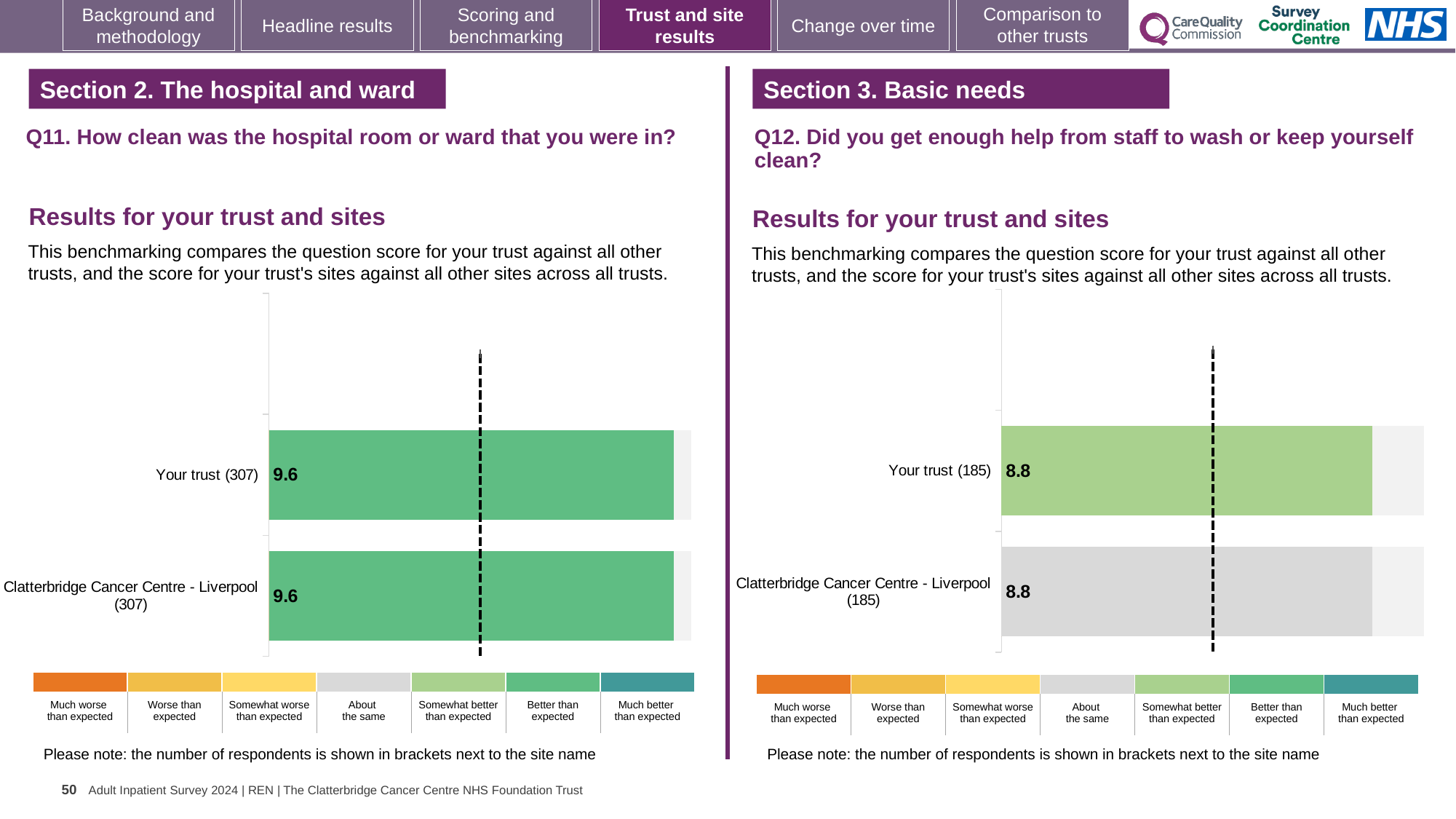
In the Q12 chart on the right, what is the score for Your trust (185)? 8.8 In the Q11 chart on the left, what is the score for Clatterbridge Cancer Centre - Liverpool (307)? 9.6 In the Q11 chart on the left, what is the score for Your trust (307)? 9.6 In the Q12 chart on the right, which benchmark category does the colour of the Clatterbridge Cancer Centre - Liverpool bar correspond to? About the same How many bars are plotted in the Q11 chart on the left? 2 In the Q11 chart on the left, which benchmark category does the colour of the Your trust bar correspond to? Better than expected How many categories does the colour legend below the Q12 chart on the right list? 7 In the Q12 chart on the right, what is the difference between the score for Your trust and the score for Clatterbridge Cancer Centre - Liverpool? 0.0 How many bars are plotted in the Q12 chart on the right? 2 In the Q11 chart on the left, what is the difference between the score for Your trust and the score for Clatterbridge Cancer Centre - Liverpool? 0.0 In the Q12 chart on the right, what is the score for Clatterbridge Cancer Centre - Liverpool (185)? 8.8 What type of chart is used for the Q11 results on the left? Bar chart